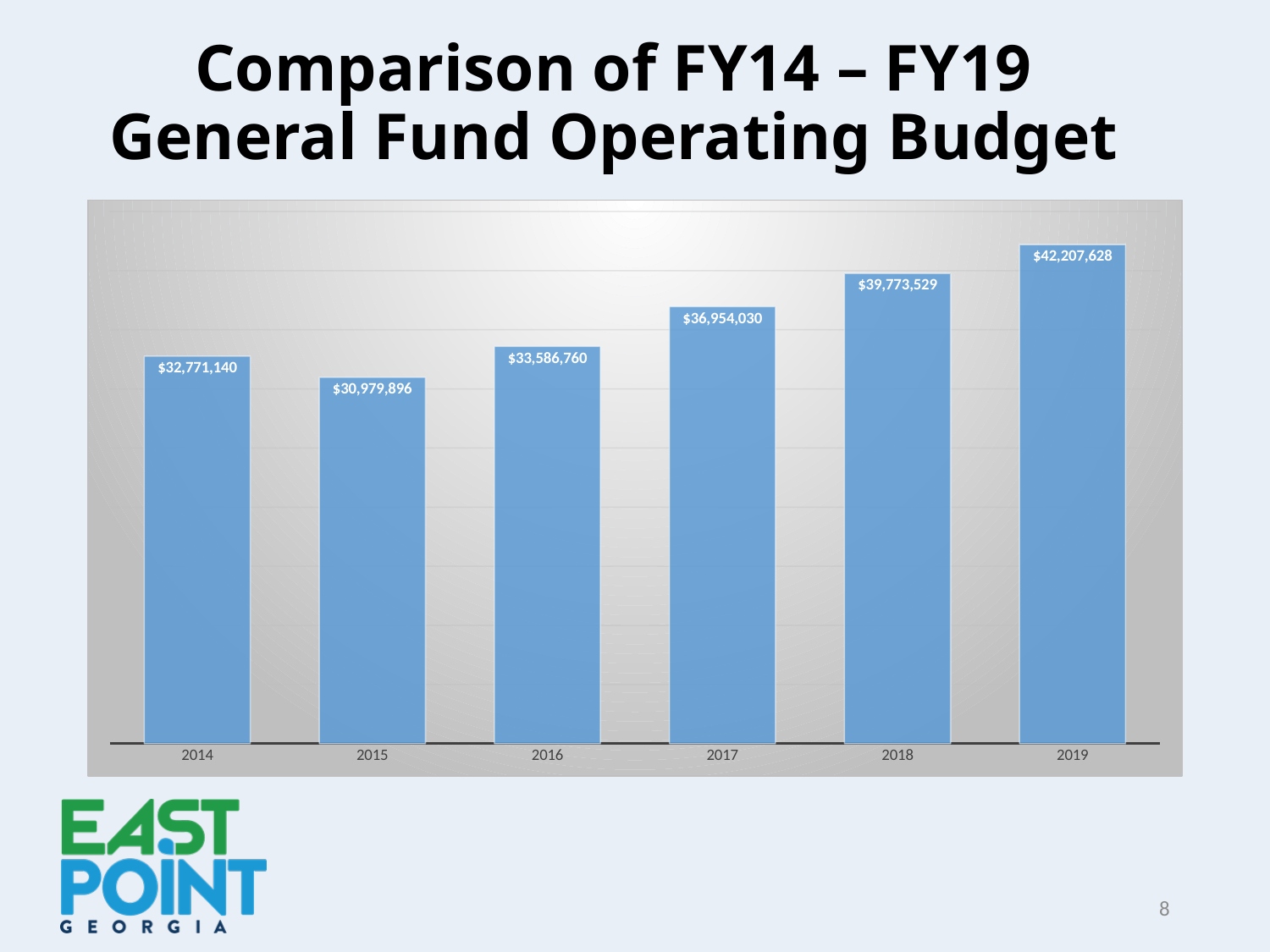
What is the difference between the 2019 and 2014 budgets? $9,436,488 What is the General Fund Operating Budget for 2019? $42,207,628 Which is larger, the budget for 2016 or the budget for 2014? 2016 What is the General Fund Operating Budget for 2017? $36,954,030 Which year has the highest General Fund Operating Budget? 2019 How much larger is the 2014 budget than the 2015 budget? $1,791,244 What kind of chart is shown on the slide? Bar chart What is the difference between the 2019 and 2018 budgets? $2,434,099 From 2015 to 2019, do the budget values rise or fall? Rise How many years are shown on the chart? 6 Which year has the lowest General Fund Operating Budget? 2015 What is the General Fund Operating Budget for 2015? $30,979,896